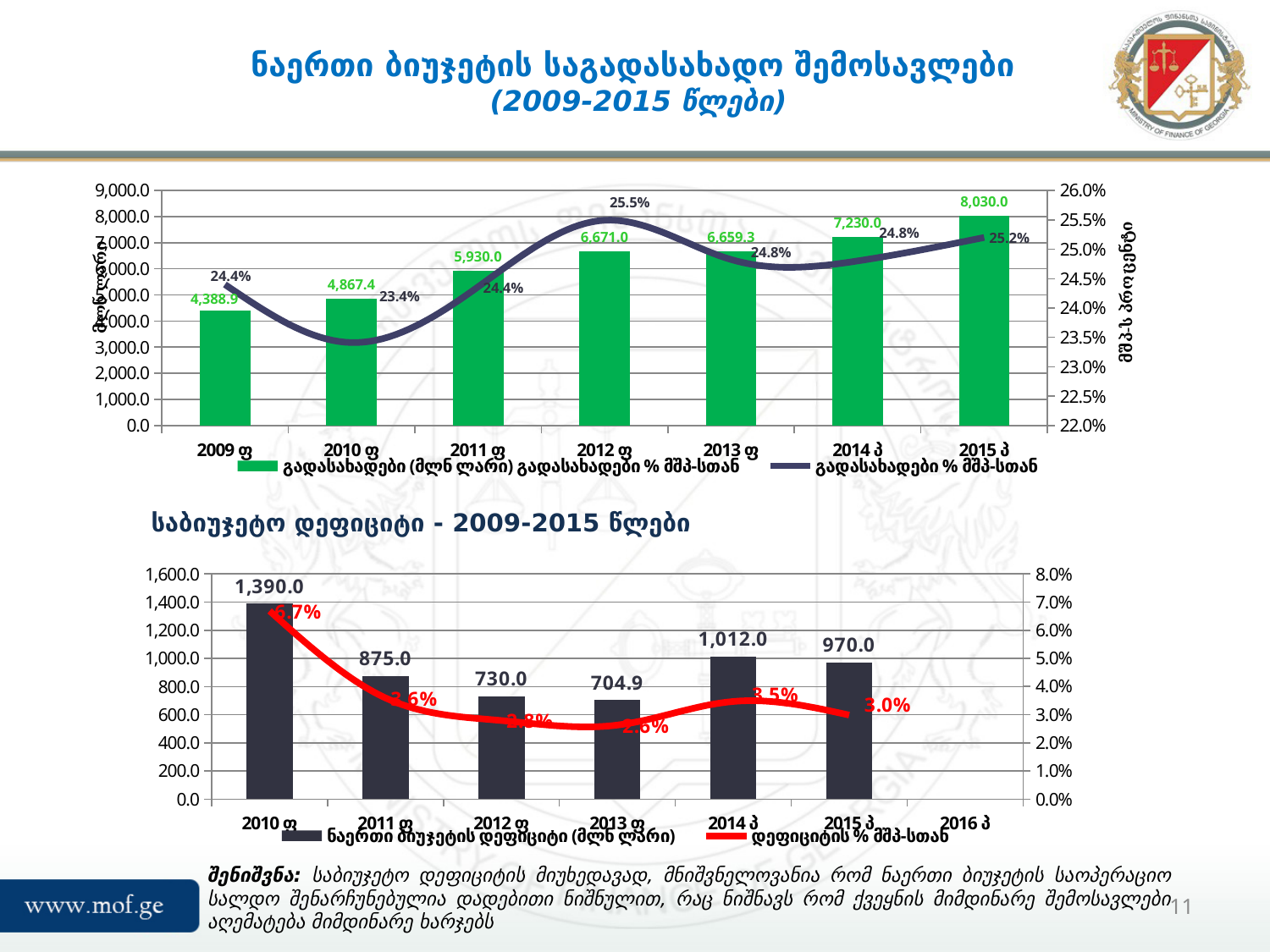
In the top chart, what percentage is shown on the line for 2012? 25.5% What type of chart is the bottom chart? Combined bar and line chart In the bottom chart, is the bar for 2014 larger or smaller than the bar for 2015? larger In the bottom chart, what is the value of the bar for 2010? 1,390.0 In the bottom chart, which year has the lowest bar? 2013 In the top chart, how many bars are plotted? 7 In the bottom chart, what percentage is shown on the line for 2015? 3.0% In the top chart, what is the value of the bar for 2009? 4,388.9 In the top chart, what is the difference between the bar values for 2015 and 2014? 800.0 In the top chart, what is the value of the bar for 2015? 8,030.0 In the top chart, which year has the highest bar? 2015 In the top chart, which year has the lowest bar? 2009